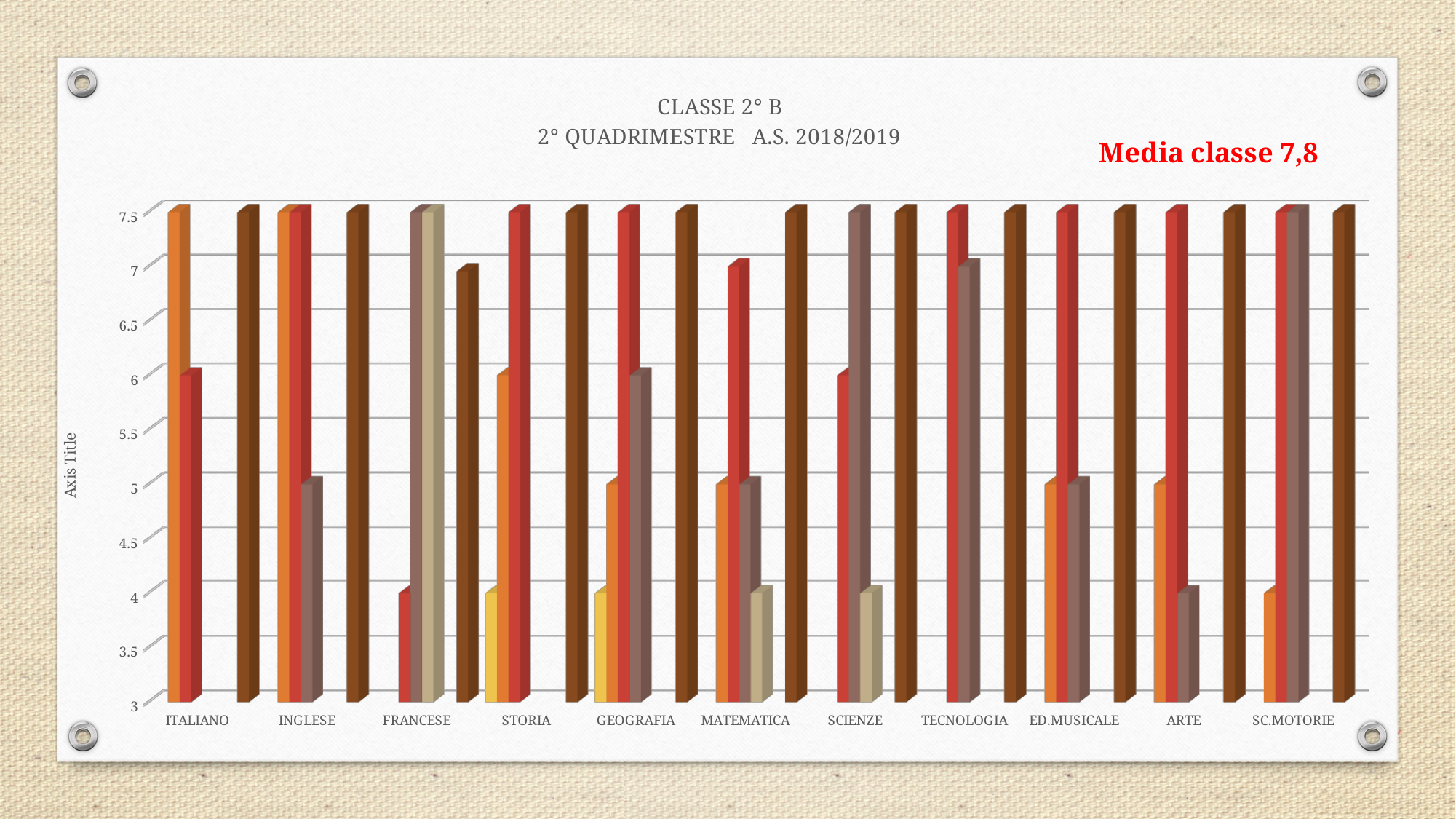
What kind of chart is shown on the slide? bar chart Which is larger: the rightmost dark brown bar for FRANCESE or the rightmost dark brown bar for STORIA? STORIA Is the lowest bar for ITALIANO greater or less than 5.5? greater For ITALIANO, what value does the red bar reach? 6 How many subject categories are shown along the x axis of the chart? 11 What is the title of the chart? CLASSE 2° B 2° QUADRIMESTRE A.S. 2018/2019 Is the lowest bar for TECNOLOGIA greater or less than 6.5? greater What is the lowest value shown on the vertical axis? 3 What class average (Media classe) is written in red on the slide? 7,8 Is the lowest bar for FRANCESE greater or less than 5? less